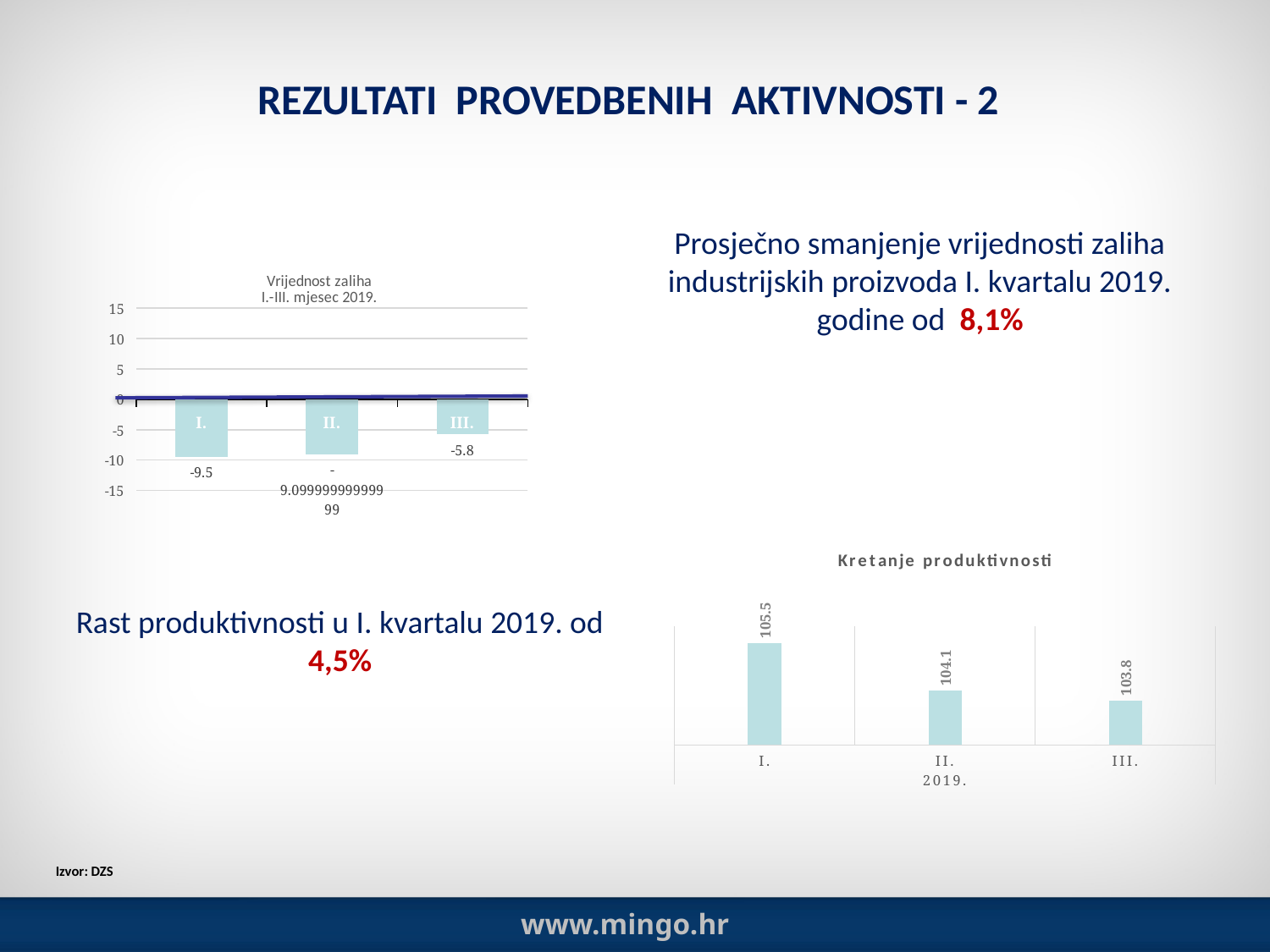
In the 'Vrijednost zaliha I.-III. mjesec 2019.' chart, what is the value for I.? -9.5 In the 'Kretanje produktivnosti' chart, what is the value for I.? 105.5 In the 'Kretanje produktivnosti' chart, what is the value for II.? 104.1 In the 'Vrijednost zaliha I.-III. mjesec 2019.' chart, is the value for II. greater or less than -5? less In the 'Vrijednost zaliha I.-III. mjesec 2019.' chart, what is the value for III.? -5.8 What kind of chart is the 'Kretanje produktivnosti' chart? bar chart In the 'Kretanje produktivnosti' chart, what is the value for III.? 103.8 In the 'Vrijednost zaliha I.-III. mjesec 2019.' chart, how many categories are shown on the x axis? 3 In the 'Vrijednost zaliha I.-III. mjesec 2019.' chart, which month has the highest value? III. In the 'Kretanje produktivnosti' chart, what is the difference between the values for I. and III.? 1.7 In the 'Vrijednost zaliha I.-III. mjesec 2019.' chart, which month has the lowest value? I. In the 'Kretanje produktivnosti' chart, do the values rise or fall from I. to III.? fall